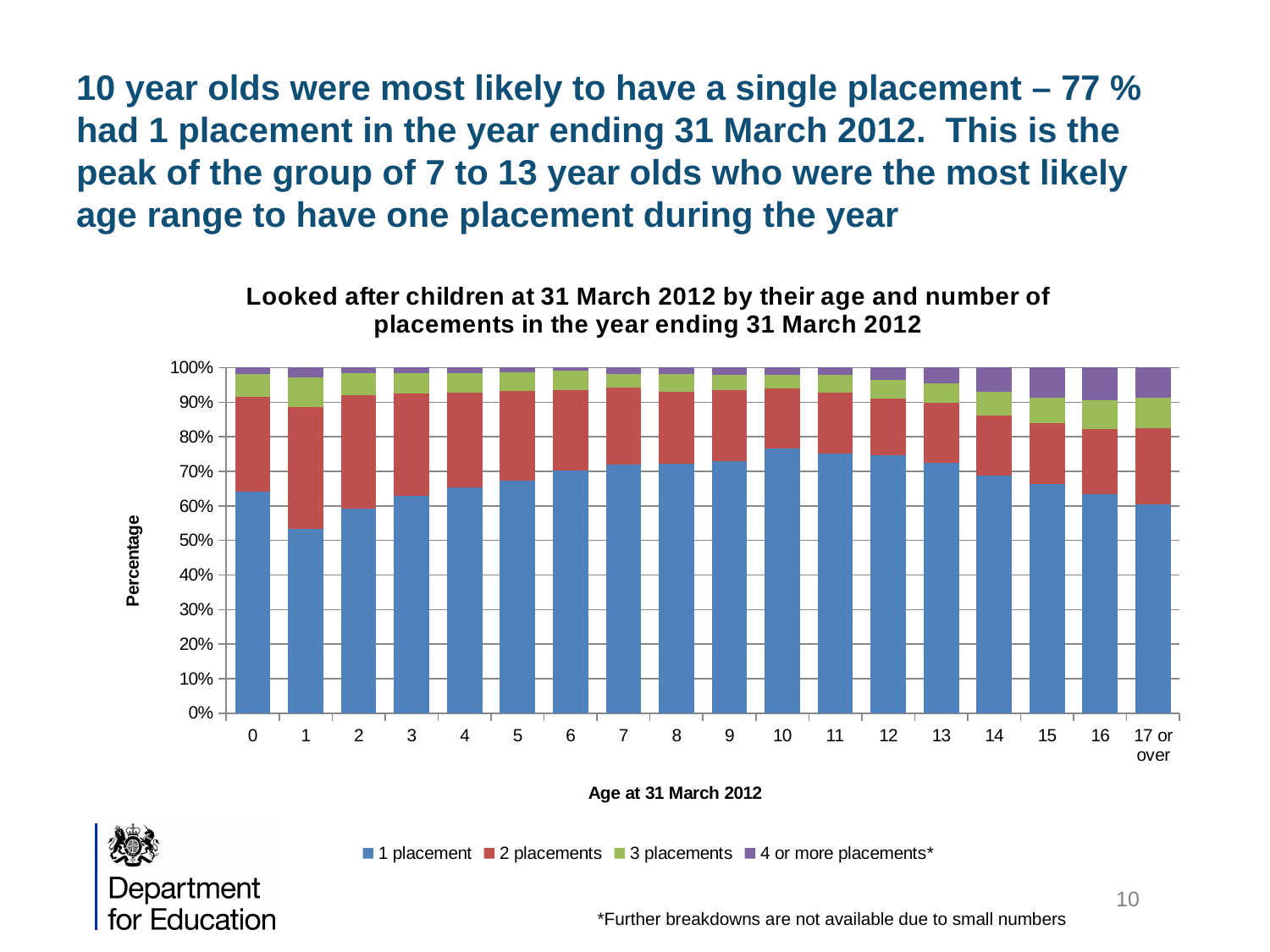
What is the total of the stacked bar for age 5? 100% Which age group has the lowest share of children with 1 placement? 1 How many age categories are shown along the x axis? 18 Is the share of 10 year olds with 1 placement greater or less than 70%? greater Which has the larger share of children with 4 or more placements: age 0 or age 17 or over? Age 17 or over What kind of chart is shown on the slide? Stacked bar chart How many series does the legend list? 4 What is the label on the x axis of the chart? Age at 31 March 2012 Which age group has the highest share of children with 1 placement? 10 Which has the larger share of children with 1 placement: age 1 or age 10? Age 10 Is the share of 1 year olds with 1 placement greater or less than 60%? less According to the slide, what percentage of 10 year olds had 1 placement in the year ending 31 March 2012? 77 %